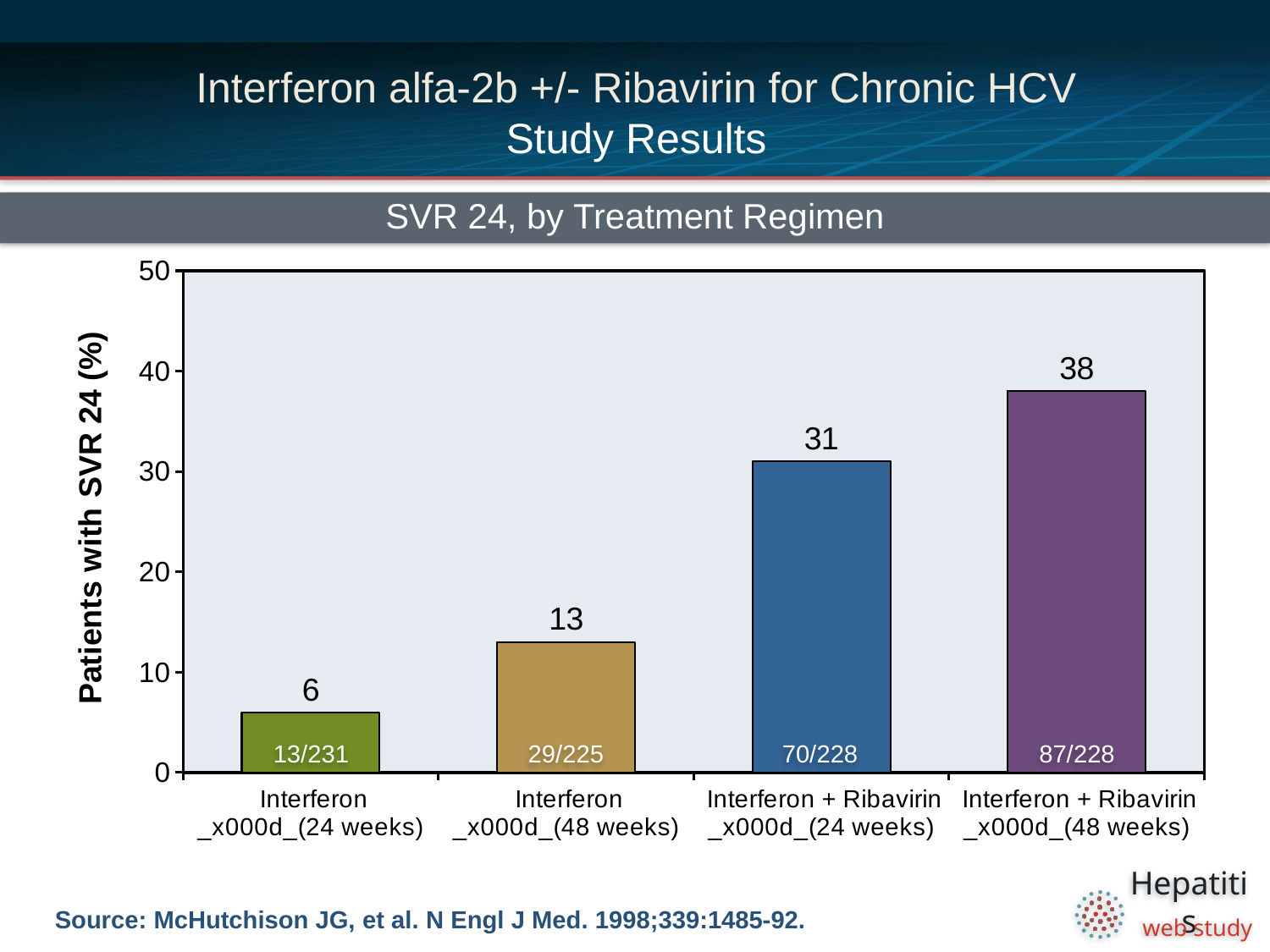
What is the value for Interferon (24 weeks)? 6 Is the value for Interferon + Ribavirin (24 weeks) greater or less than 20? greater What is the value for Interferon + Ribavirin (48 weeks)? 38 Do the values rise or fall from left to right across the treatment regimens? rise Which treatment regimen has the lowest percentage of patients with SVR 24? Interferon (24 weeks) What fraction is printed inside the bar for Interferon + Ribavirin (24 weeks)? 70/228 What kind of chart is shown on the slide? bar chart What is the difference between the values for Interferon + Ribavirin (48 weeks) and Interferon + Ribavirin (24 weeks)? 7 Which treatment regimen has the highest percentage of patients with SVR 24? Interferon + Ribavirin (48 weeks) How many treatment regimens are shown on the chart? 4 Which is larger, the value for Interferon (48 weeks) or Interferon + Ribavirin (24 weeks)? Interferon + Ribavirin (24 weeks) What is the value for Interferon (48 weeks)? 13